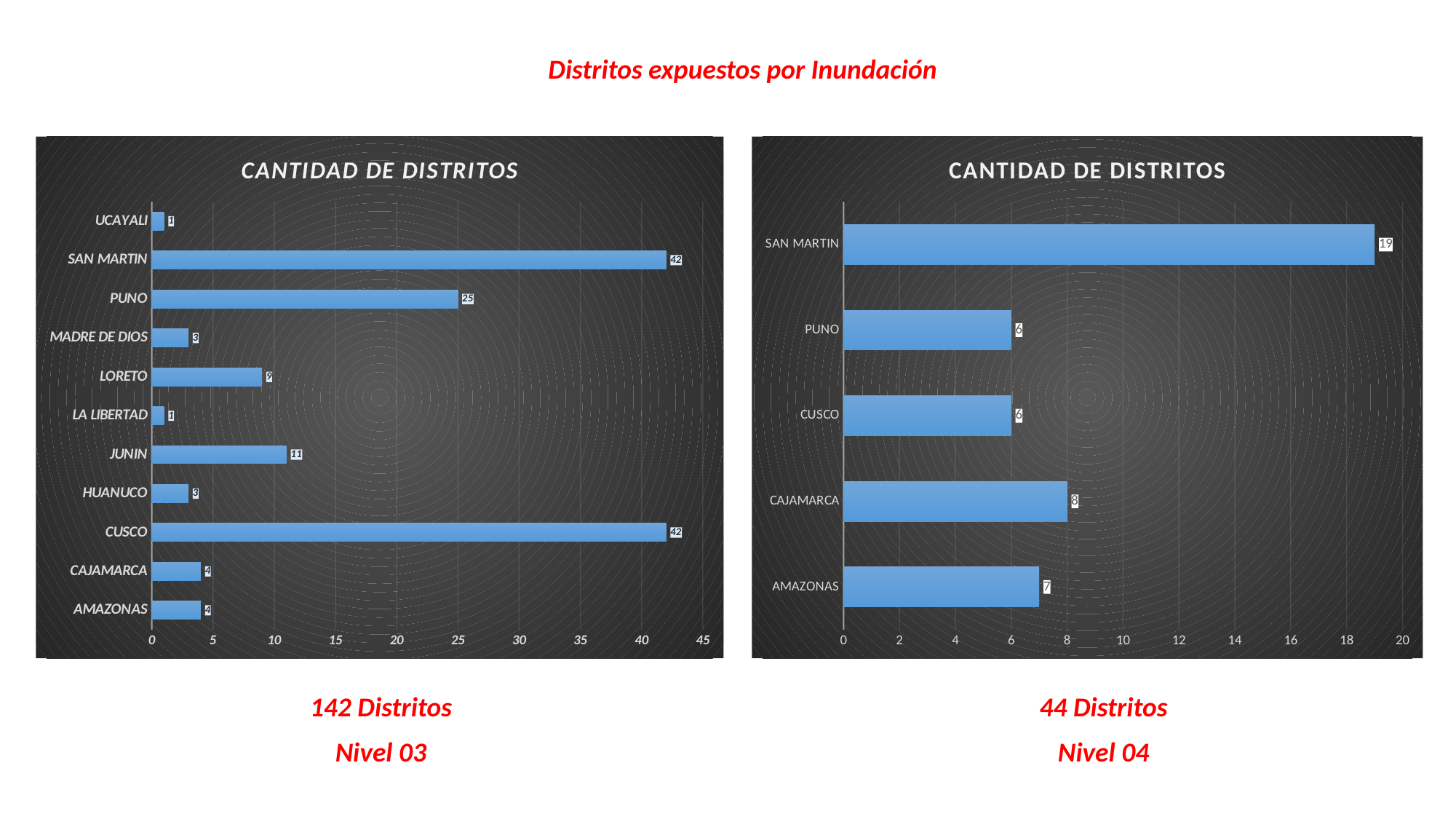
In the right chart (Nivel 04), which category has the highest value? SAN MARTIN In the left chart (Nivel 03), what is the value for PUNO? 25 In the right chart (Nivel 04), what is the difference between the values for SAN MARTIN and AMAZONAS? 12 In the left chart (Nivel 03), what is the value for JUNIN? 11 In the right chart (Nivel 04), which is larger, the value for CAJAMARCA or the value for AMAZONAS? CAJAMARCA What type of chart is the right chart (Nivel 04)? Bar chart In the right chart (Nivel 04), what is the value for CAJAMARCA? 8 How many categories are shown in the right chart (Nivel 04)? 5 In the left chart (Nivel 03), what is the value for LORETO? 9 In the left chart (Nivel 03), what is the difference between the values for SAN MARTIN and PUNO? 17 In the left chart (Nivel 03), which is larger, the value for LORETO or the value for JUNIN? JUNIN How many categories are shown in the left chart (Nivel 03)? 11